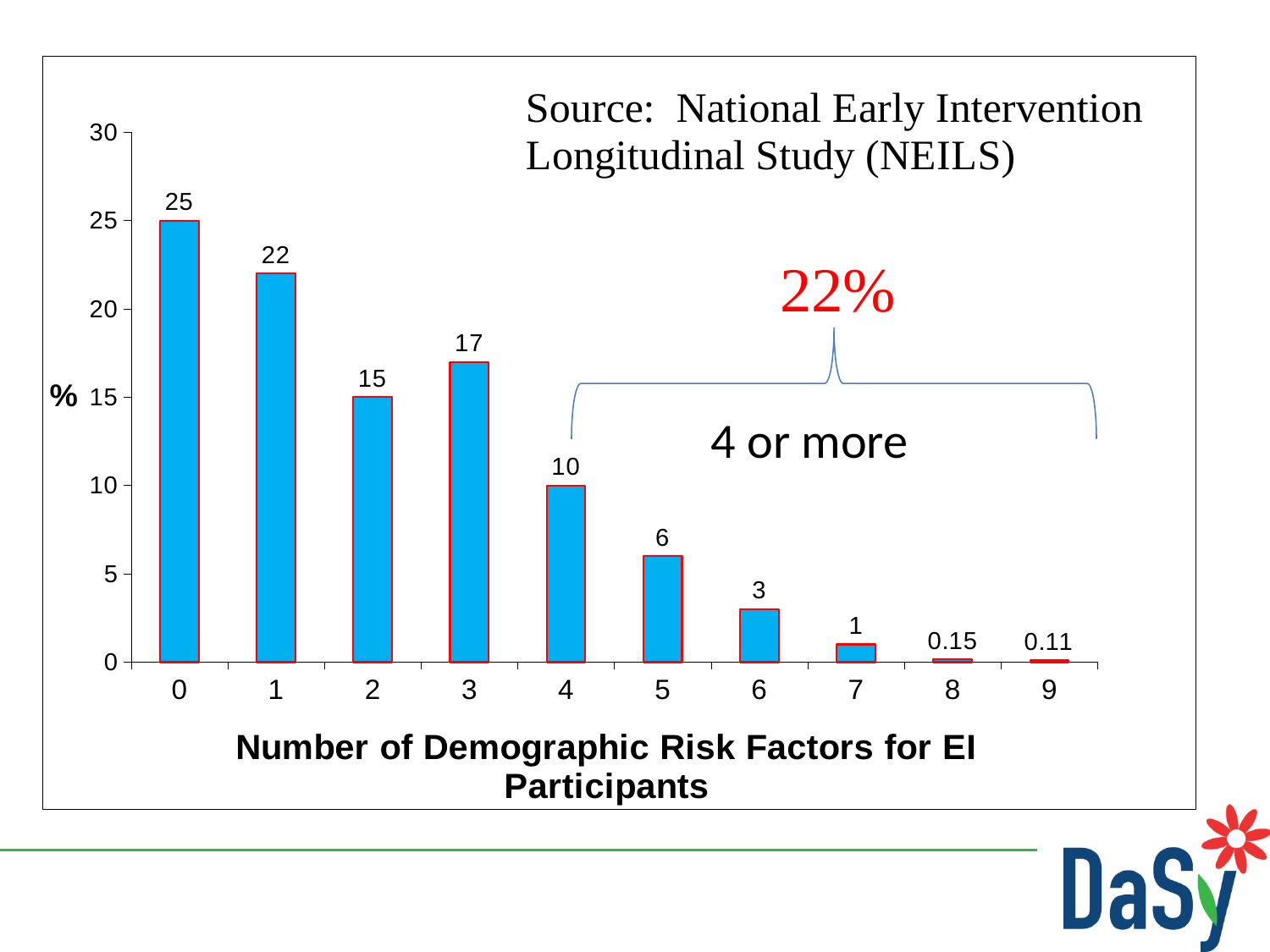
What is the value shown for 8 demographic risk factors? 0.15 What kind of chart is shown on the slide? Bar chart Which number of risk factors has the lowest percentage? 9 How many categories are shown on the x axis? 10 What is the x-axis title of the chart? Number of Demographic Risk Factors for EI Participants What is the value shown for 3 demographic risk factors? 17 What percentage is annotated for the '4 or more' group? 22% Do the values rise or fall as the number of risk factors increases? Fall What percentage of EI participants have 0 demographic risk factors? 25 What is the difference between the values for 1 and 2 risk factors? 7 Which number of risk factors has the highest percentage? 0 Which is larger, the value for 4 risk factors or the value for 5 risk factors? 4 risk factors